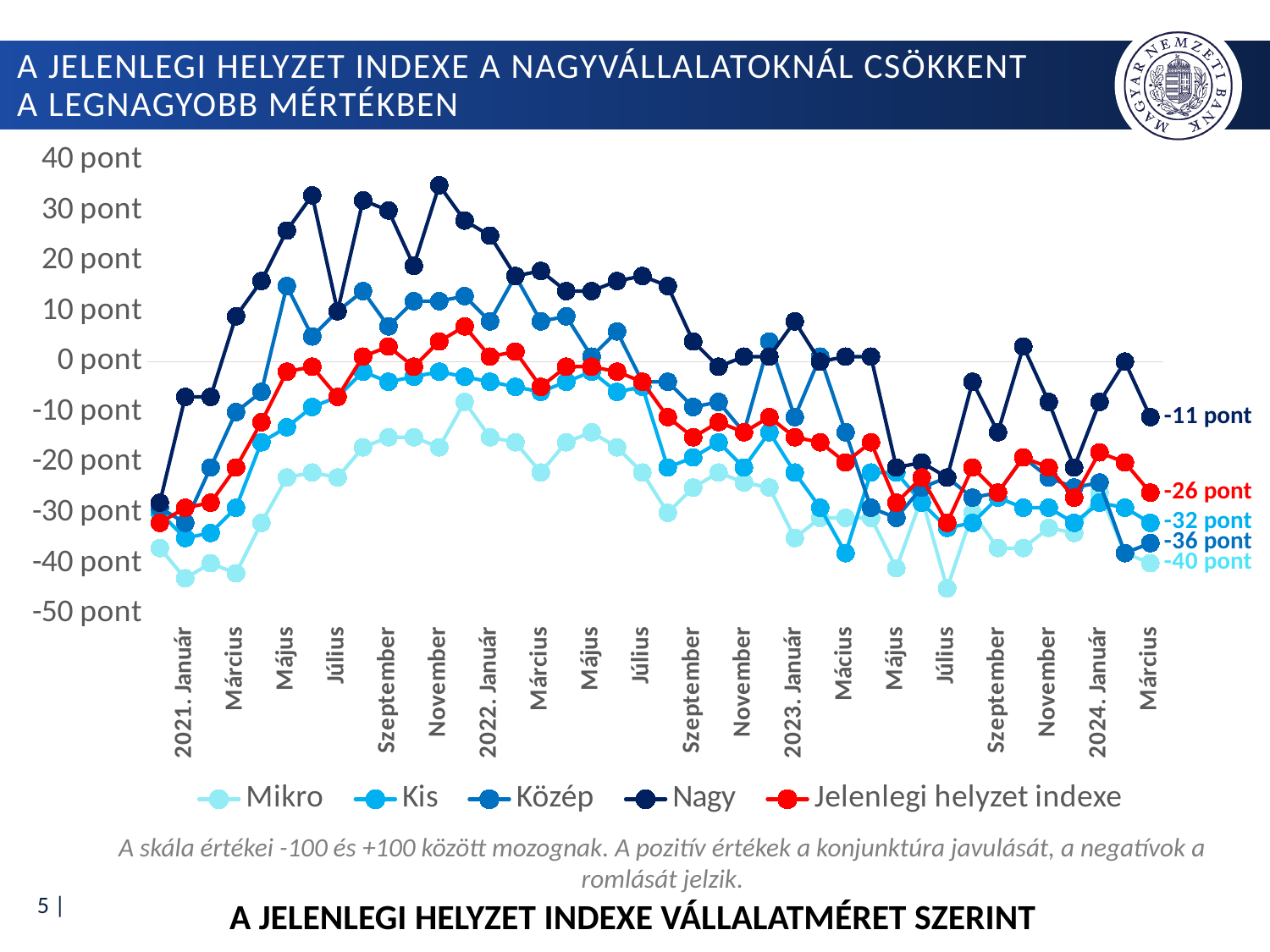
What is the final value shown for the Jelenlegi helyzet indexe series in March 2024? -26 pont What is the final value shown for the Nagy series in March 2024? -11 pont Which series has the lowest value at the last data point (March 2024)? Mikro Does the Nagy series rise or fall between 2021 January and 2021 May? Rise How many series does the legend list? 5 What is the difference between the final values of the Nagy and Mikro series? 29 pont At the last data point, which is higher: Kis or Közép? Kis Which series has the highest value at the last data point (March 2024)? Nagy What is the final value shown for the Kis series in March 2024? -32 pont Is the value for Nagy in November 2021 greater or less than 30 pont? greater What is the final value shown for the Mikro series in March 2024? -40 pont What kind of chart is shown on the slide? Line chart